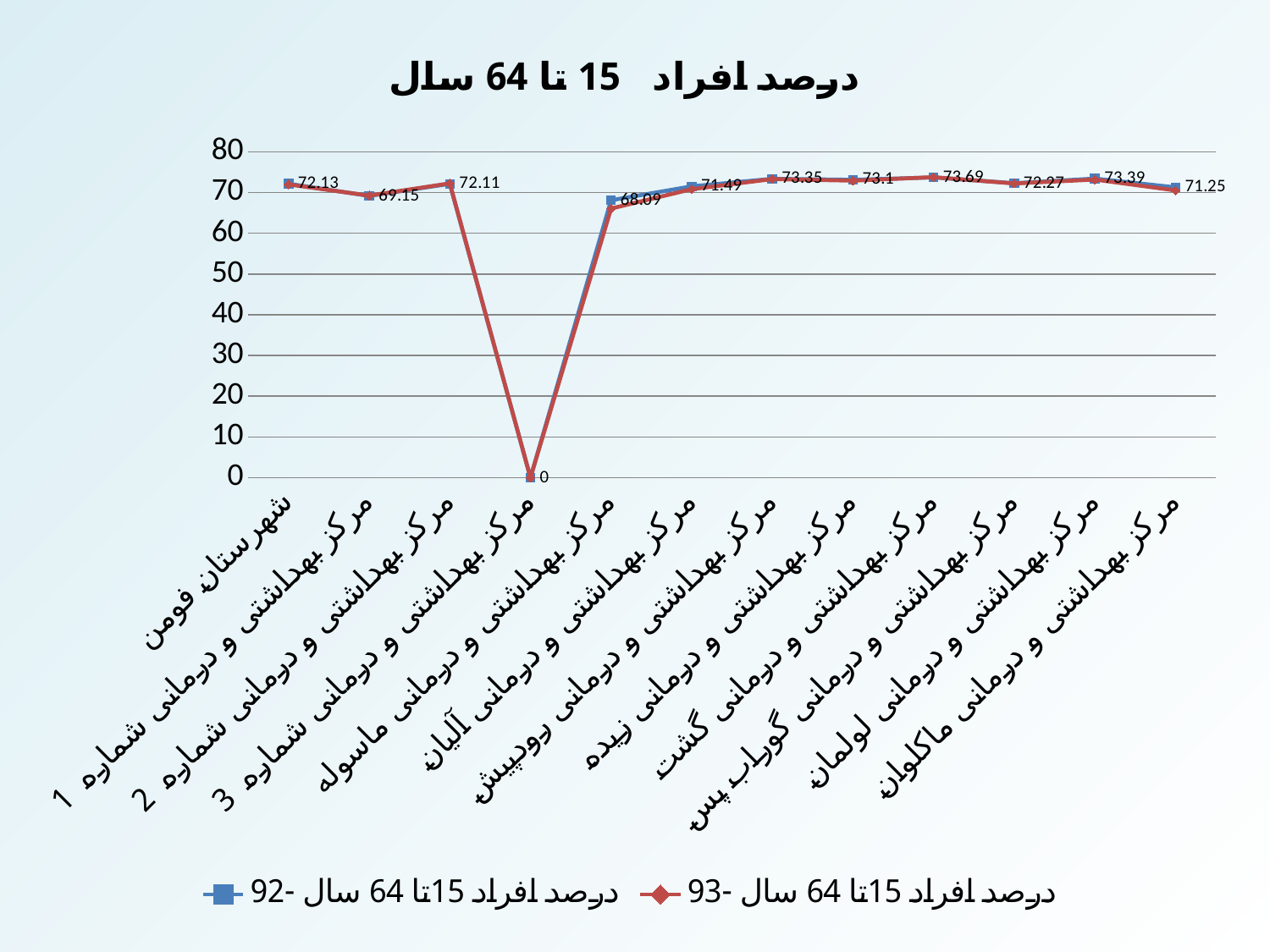
Is the value for مرکز بهداشتی و درمانی ماکلوان greater or less than 60? greater What is the title of the chart? درصد افراد 15 تا 64 سال What is the data label shown at شهرستان فومن? 72.13 Which category has the lowest labelled value? مرکز بهداشتی و درمانی شماره 3 What is the data label shown at مرکز بهداشتی و درمانی ماسوله? 68.09 Which category has the highest labelled value? مرکز بهداشتی و درمانی گشت Which has the larger labelled value: مرکز بهداشتی و درمانی شماره 2 or مرکز بهداشتی و درمانی آلیان? مرکز بهداشتی و درمانی شماره 2 How many series does the legend list? 2 How many categories are plotted along the x axis? 12 What is the difference between the labelled values at شهرستان فومن and مرکز بهداشتی و درمانی شماره 2? 0.02 What kind of chart is shown on the slide? line chart What is the data label shown at مرکز بهداشتی و درمانی گوراب پس? 72.27